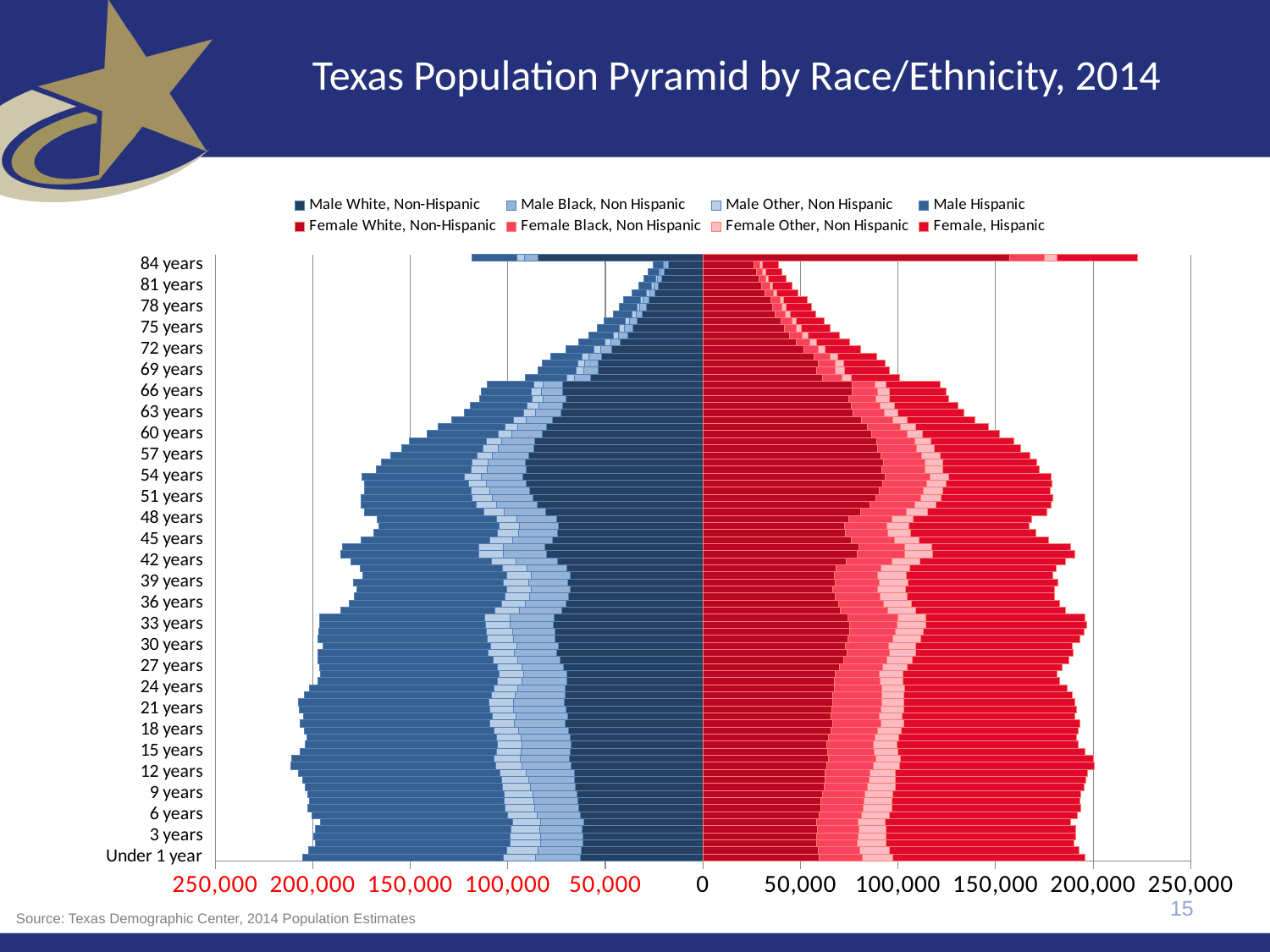
Which is larger at 84 years: the total male bar or the total female bar? Female Is the total male value for 84 years greater or less than 150,000? less What is the title of the chart? Texas Population Pyramid by Race/Ethnicity, 2014 Which is larger for males: the total bar at 12 years or at 84 years? 12 years What type of chart is shown on the slide? Bar chart (population pyramid) Is the total male value for 12 years greater or less than 200,000? greater How many series does the legend list? 8 Is the total male value for 78 years greater or less than 50,000? less On which side of the chart are the male series plotted? Left